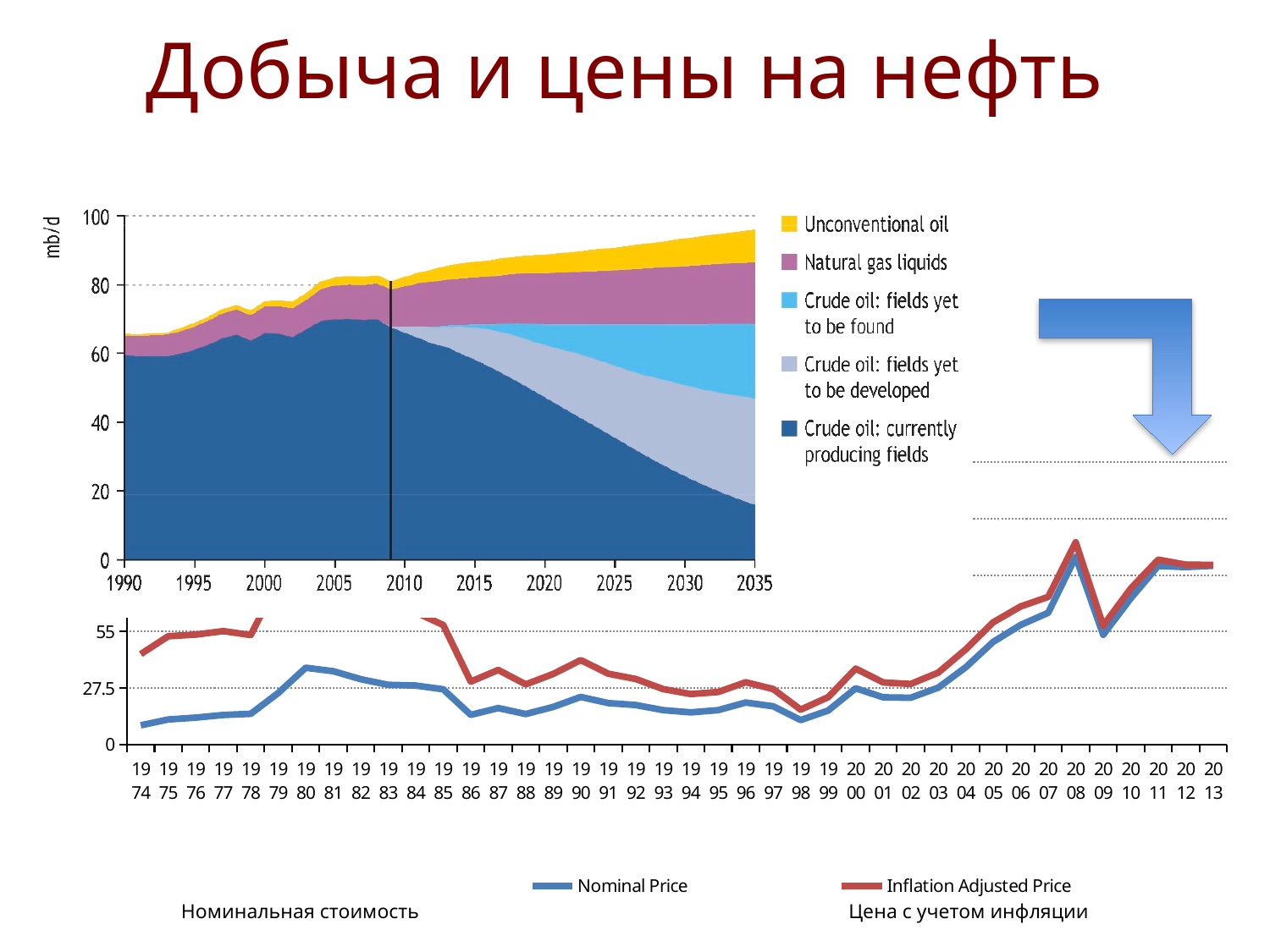
How many series does the legend of the top-left production chart list? 5 In the bottom price chart, which is larger in 1990: the Nominal Price or the Inflation Adjusted Price? Inflation Adjusted Price In the bottom price chart, which year has the higher Nominal Price: 2008 or 2009? 2008 How many series does the legend of the bottom price chart list? 2 In the bottom price chart, does the Nominal Price rise or fall from 1998 to 2008? rises In the bottom price chart, is the Nominal Price for 1998 greater or less than 27.5? less What kind of chart is the bottom chart showing Nominal Price and Inflation Adjusted Price? line chart In the top-left production chart, which series forms the bottom layer of the stack? Crude oil: currently producing fields What kind of chart is the top-left chart with the mb/d axis? area chart How many years are shown on the x axis of the bottom price chart? 40 In the top-left production chart, is the total production in 2035 greater or less than 80 mb/d? greater In the bottom price chart, is the Inflation Adjusted Price for 2008 greater or less than 55? greater